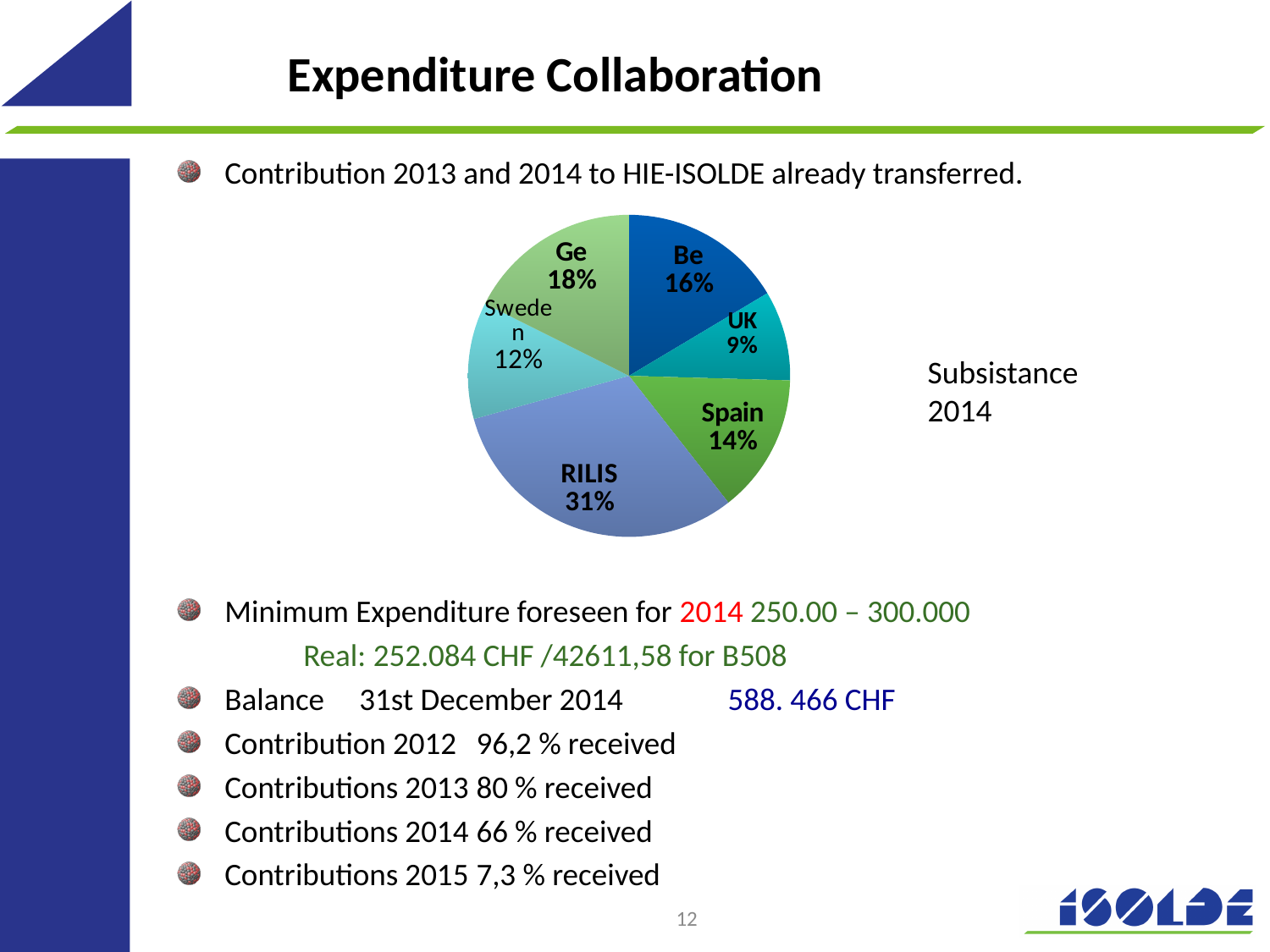
How many slices does the pie chart have? 6 What percentage is shown for Be? 16% What percentage is shown for UK? 9% Which is larger, the share for Be or the share for Spain? Be What label appears to the right of the pie chart? Subsistance 2014 What is the difference in percentage points between RILIS and Sweden? 19 What kind of chart is shown on the slide? pie chart What share of the pie does RILIS have? 31% Which slice of the pie chart is the smallest? UK Which slice of the pie chart is the largest? RILIS What percentage is shown for Sweden? 12% What is the difference in percentage points between Ge and Spain? 4